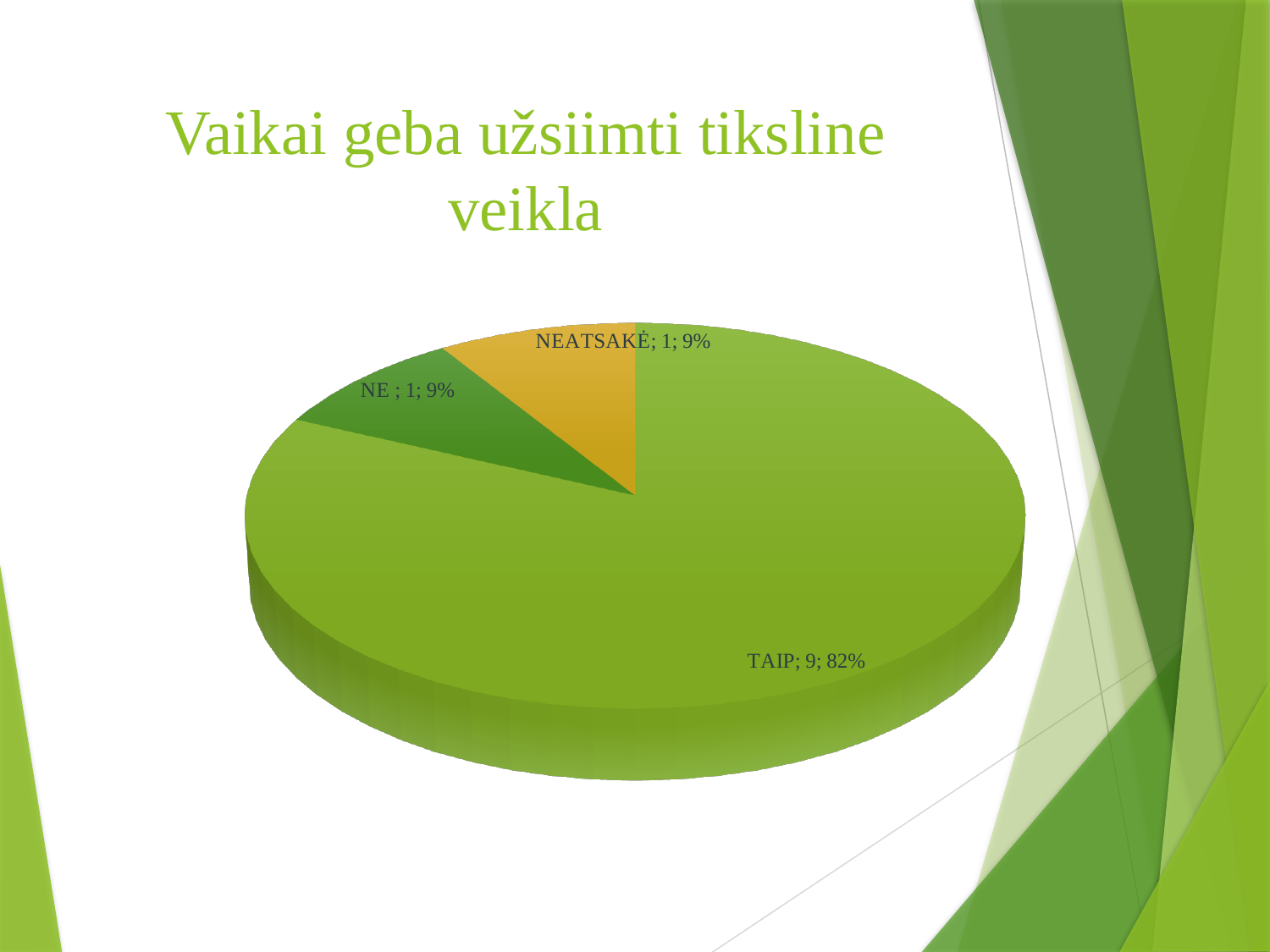
What is the title of the slide? Vaikai geba užsiimti tiksline veikla What is the count for TAIP? 9 What colour is the NEATSAKĖ slice? yellow/orange How many slices does the pie chart have? 3 What is the count for NE? 1 What is the difference in count between TAIP and NE? 8 Which category has the largest slice? TAIP What percentage share does NEATSAKĖ have? 9% What is the total count across all slices? 11 What kind of chart is shown on the slide? pie chart Which is larger, the count for TAIP or the count for NEATSAKĖ? TAIP What percentage share does TAIP have? 82%